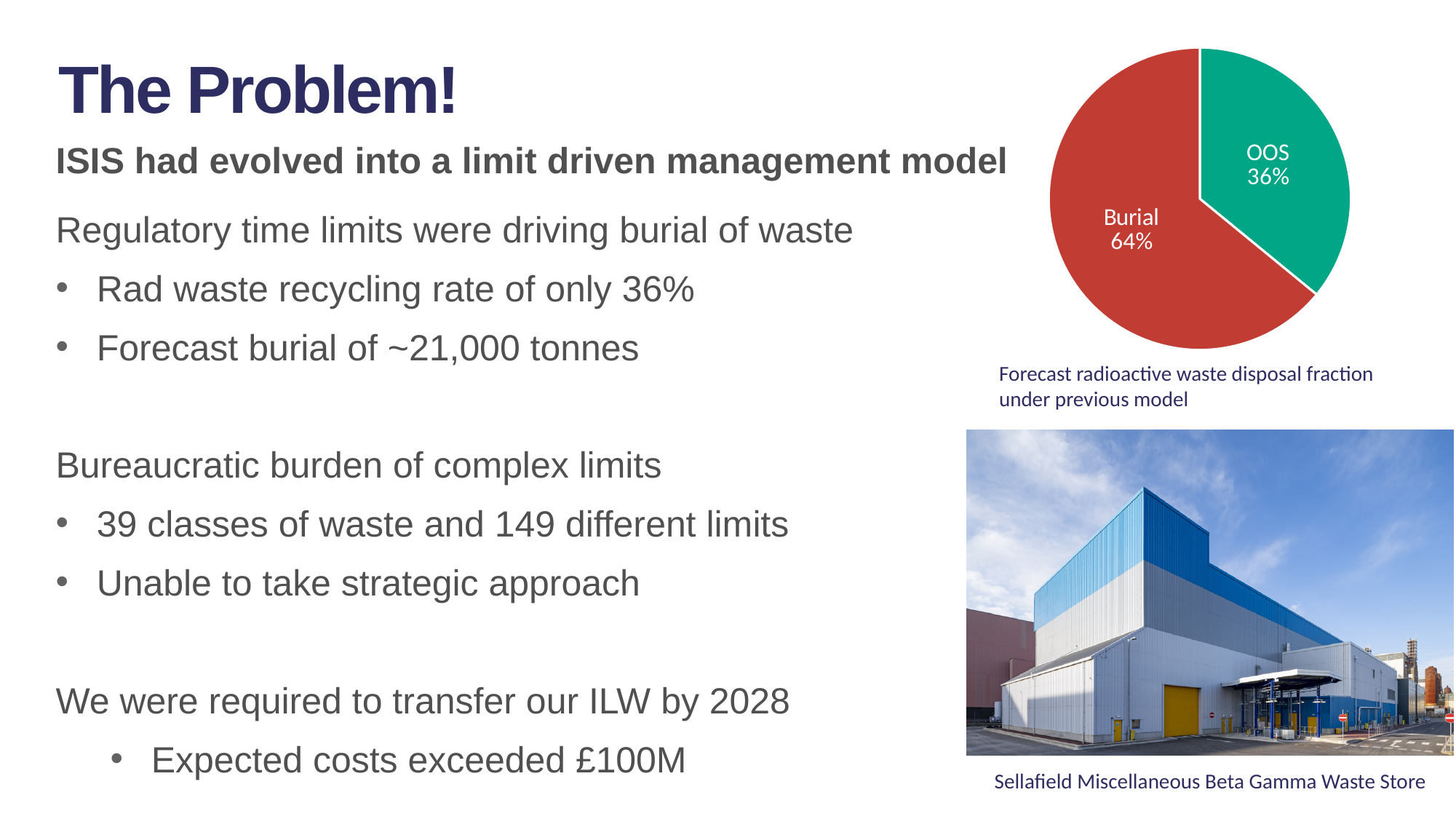
What is the difference in percentage points between the Burial and OOS slices? 28 Which slice of the pie chart is the largest? Burial Which slice of the pie chart is the smallest? OOS What share of the pie does the OOS slice represent? 36% What percentage of the pie chart is labelled OOS? 36% What caption appears below the pie chart? Forecast radioactive waste disposal fraction under previous model What percentage of the pie chart is labelled Burial? 64% What colour is the Burial slice of the pie chart? Red What kind of chart is shown on the slide? Pie chart Which is larger in the pie chart, Burial or OOS? Burial How many slices does the pie chart have? 2